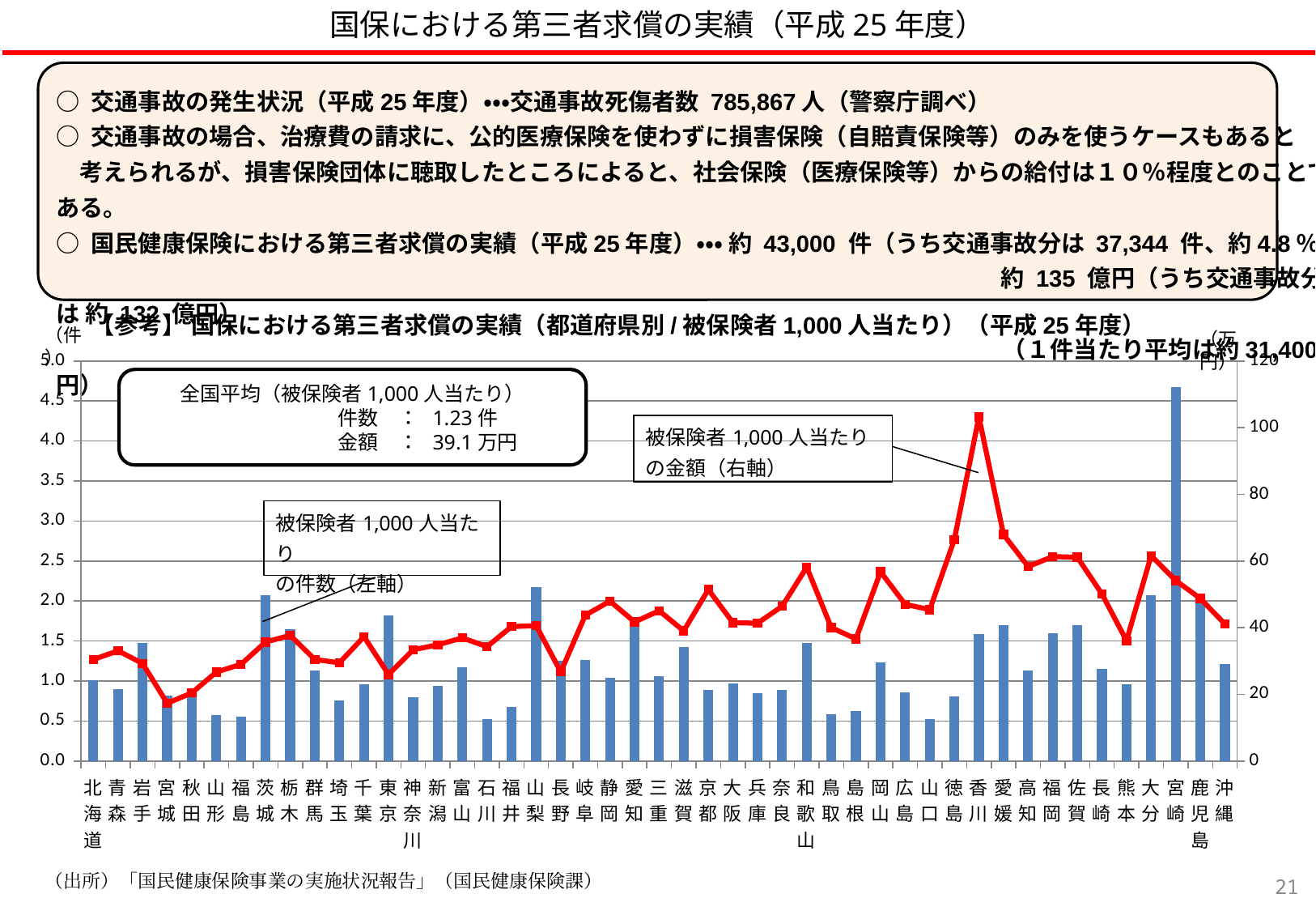
Which prefecture has the highest point on the red line (金額 per 1,000 insured persons)? 香川 How many prefectures are plotted along the x axis of the chart? 47 Which prefecture has the lowest point on the red line (金額 per 1,000 insured persons)? 宮城 Which prefecture has the highest bar (件数 per 1,000 insured persons)? 宮崎 What kind of chart is shown on the slide? A combined bar and line chart Is the bar value for 東京 greater or less than 1.5? greater Which axis is used for the red line series (被保険者1,000人当たりの金額)? The right axis Which has the larger bar value, 宮崎 or 大分? 宮崎 Which has the larger red line value, 香川 or 徳島? 香川 Is the bar value for 宮崎 greater or less than 4.0? greater Is the bar value for 石川 greater or less than 1.0? less